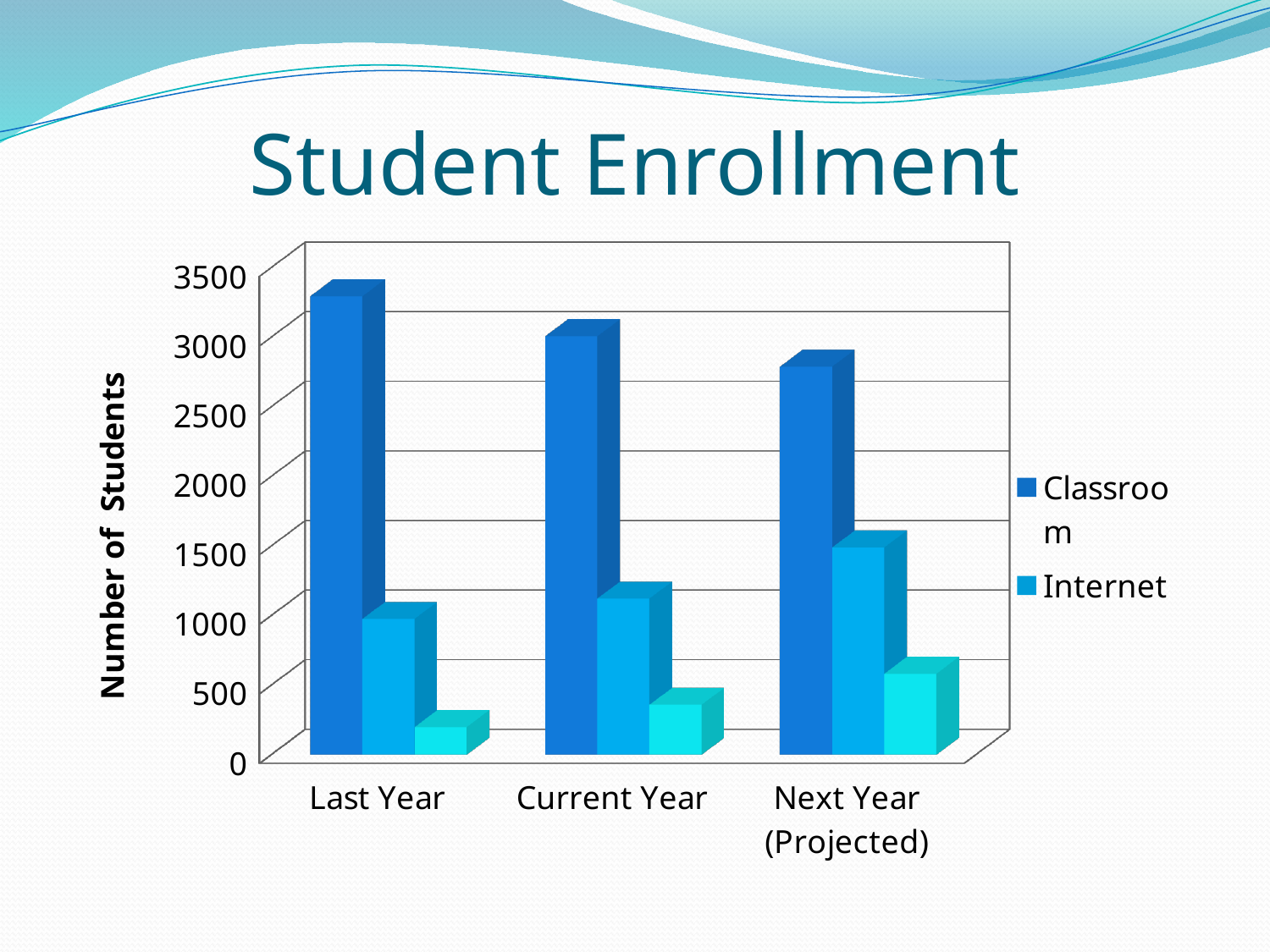
How many series does the legend list? 2 Is the Classroom value for Next Year (Projected) greater or less than 3000? less In which category is the Internet value lowest? Last Year Do the Internet values rise or fall from Last Year to Next Year (Projected)? Rise How many categories are shown on the x axis of the chart? 3 Which is larger, the Classroom value for Last Year or the Classroom value for Current Year? Last Year Is the Classroom value for Last Year greater or less than 3000? greater What is the title of the chart? Student Enrollment Do the Classroom values rise or fall from Last Year to Next Year (Projected)? Fall What is the label of the vertical axis? Number of Students What kind of chart is shown on the slide? Bar chart In which category is the Classroom value highest? Last Year